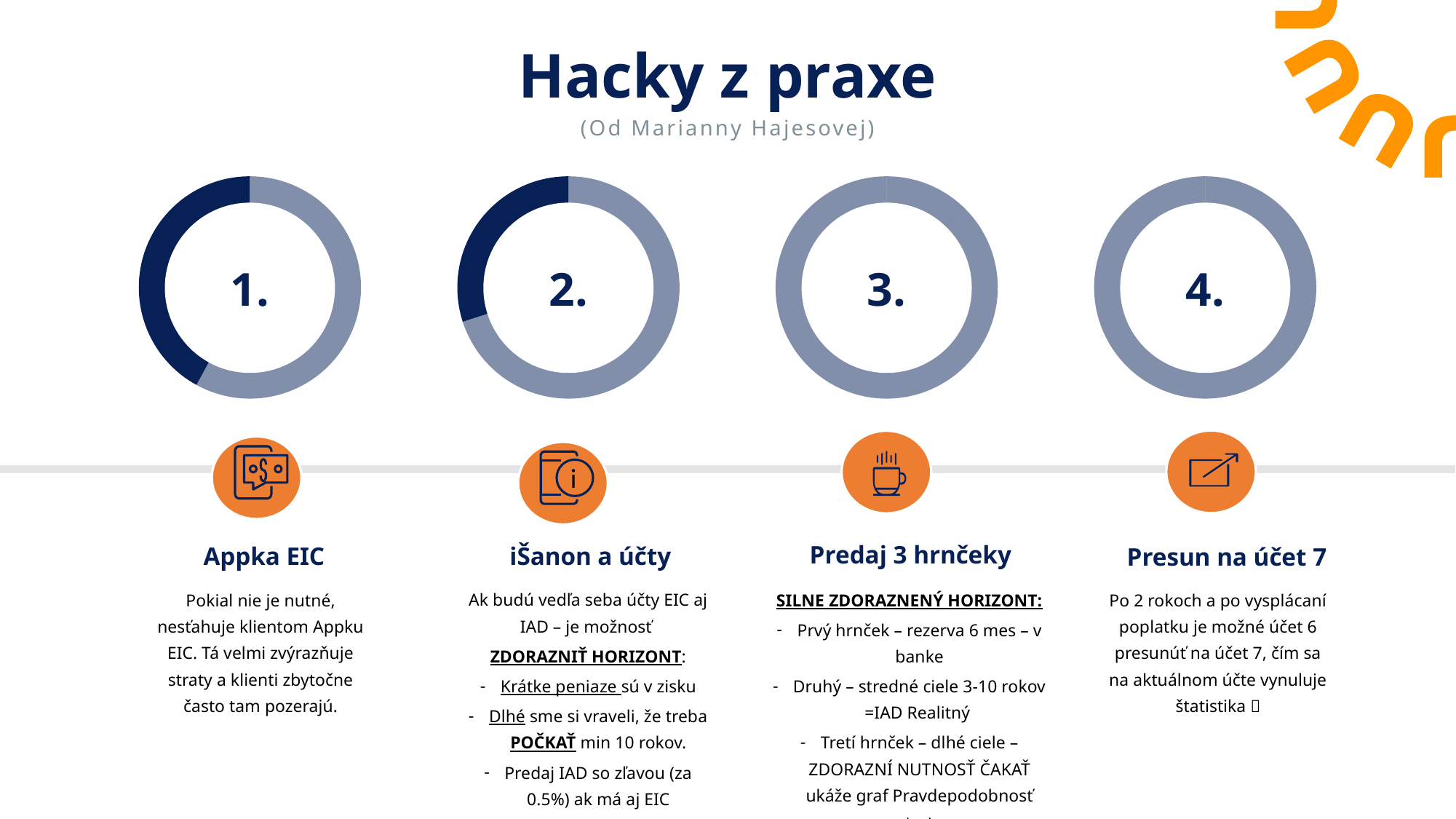
How many doughnut charts are on the slide? 4 Which doughnut chart has the largest dark-blue filled portion? 1. Is the dark-blue filled portion larger in the doughnut chart labelled "1." or in the one labelled "2."? 1. Does the doughnut chart labelled "3." show any dark-blue filled portion? No What kind of chart is shown above the label "Appka EIC"? doughnut chart What number is printed in the centre of the doughnut chart above "Presun na účet 7"? 4.